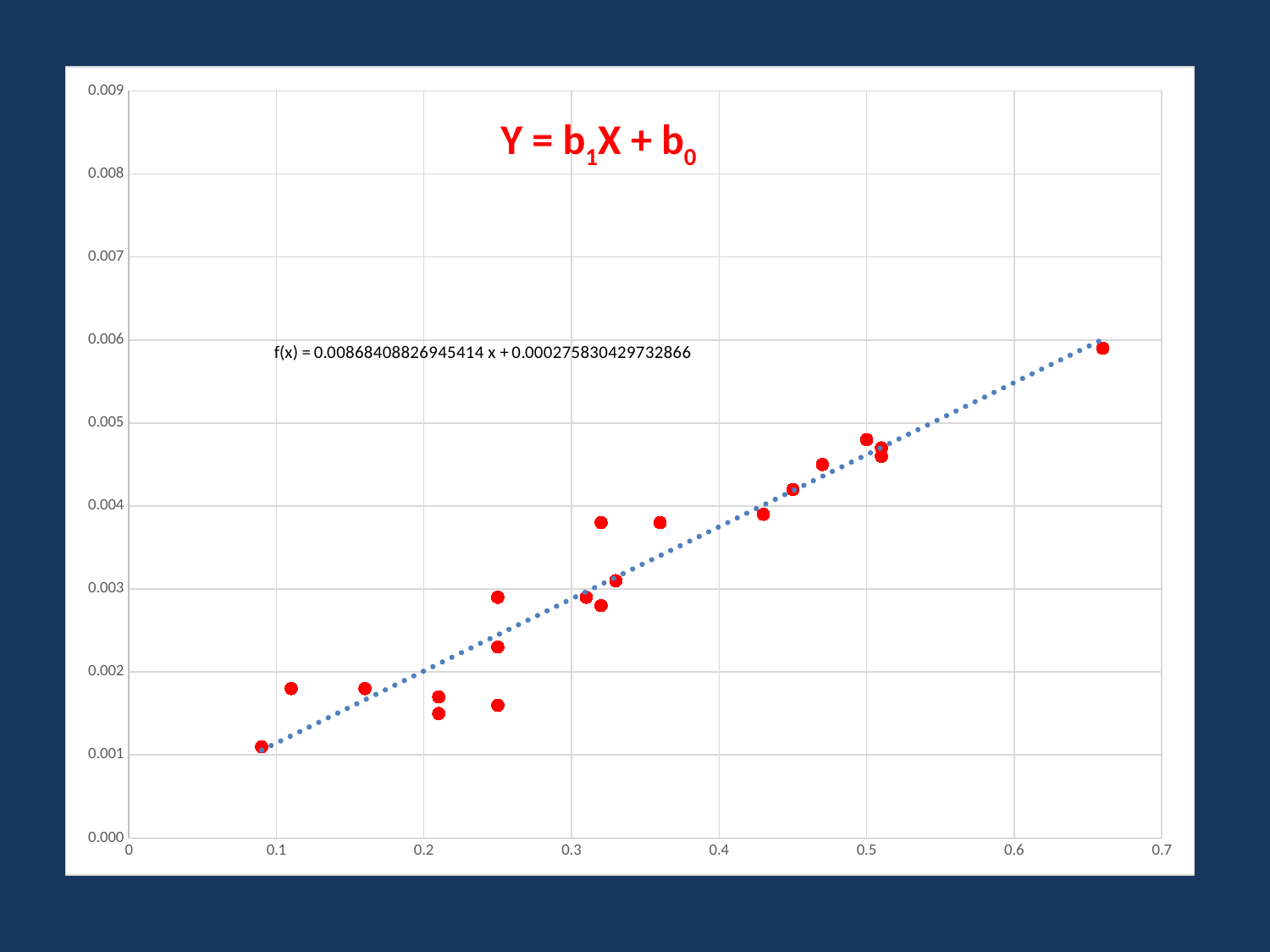
Is the y value of the point at x ≈ 0.16 greater or less than 0.003? less Do the plotted points generally rise or fall as x increases? rise Is the y value of the rightmost point (at x ≈ 0.66) greater or less than 0.005? greater Is the y value of the leftmost point (at x ≈ 0.09) greater or less than 0.002? less Which point has the highest y value: the one at x ≈ 0.66 or the one at x ≈ 0.5? the one at x ≈ 0.66 What is the highest value shown on the y axis? 0.009 What kind of chart is shown on the slide? scatter chart What equation is printed for the trendline on the chart? f(x) = 0.00868408826945414 x + 0.000275830429732866 Which point has the lowest y value: the one at x ≈ 0.09 or the one at x ≈ 0.11? the one at x ≈ 0.09